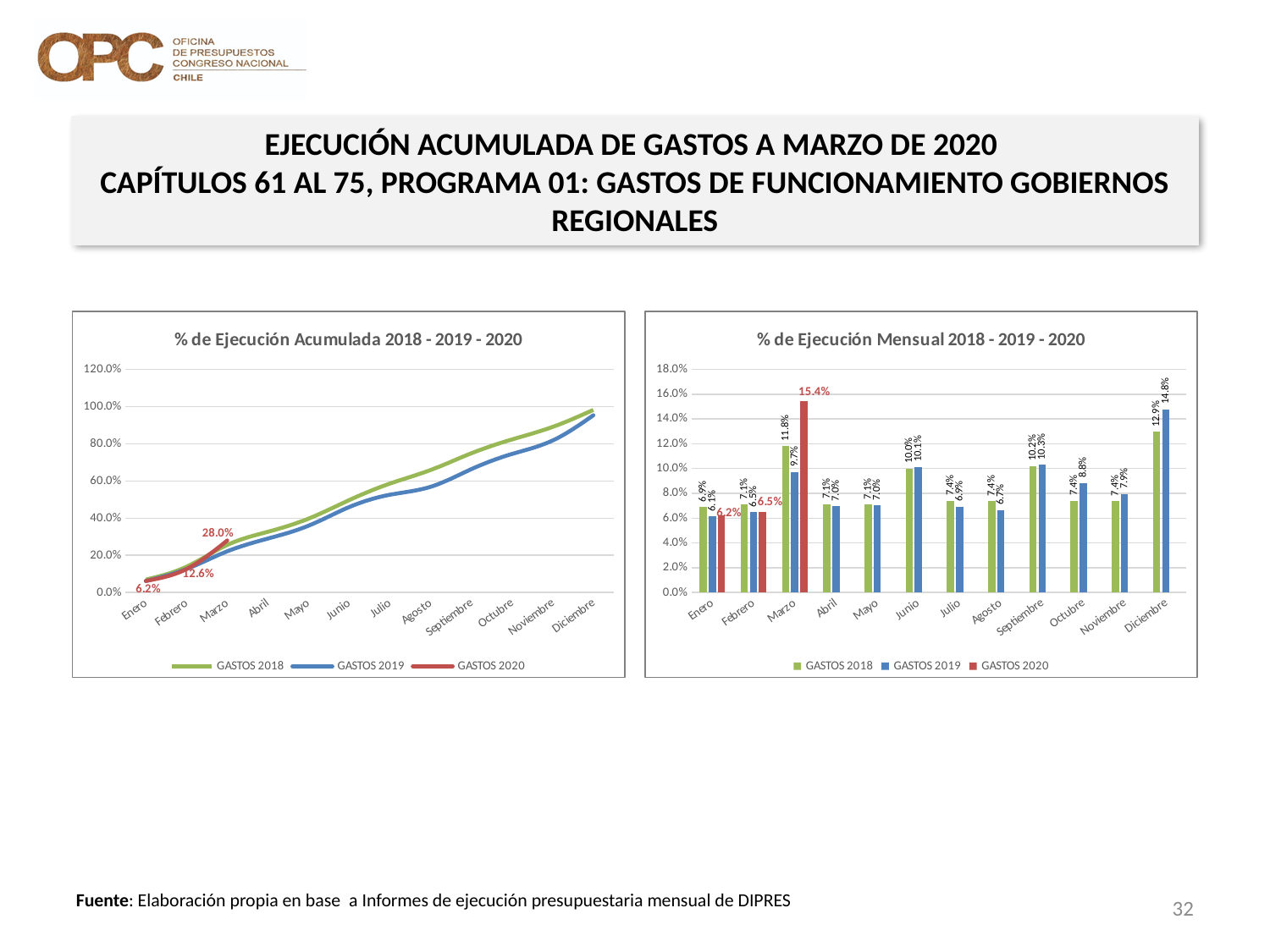
What kind of chart is the left chart titled '% de Ejecución Acumulada 2018 - 2019 - 2020'? Line chart What kind of chart is the right chart titled '% de Ejecución Mensual 2018 - 2019 - 2020'? Bar chart In the right chart '% de Ejecución Mensual', which month has the highest GASTOS 2018 value? Diciembre In the left chart '% de Ejecución Acumulada', does the GASTOS 2018 line rise or fall from Enero to Diciembre? Rises How many series does the legend of the right chart '% de Ejecución Mensual' list? 3 In the right chart '% de Ejecución Mensual', what is the GASTOS 2019 value for Octubre? 8.8% In the right chart '% de Ejecución Mensual', which is larger for Diciembre: GASTOS 2018 or GASTOS 2019? GASTOS 2019 In the right chart '% de Ejecución Mensual', which month has the lowest GASTOS 2019 value? Enero In the right chart '% de Ejecución Mensual', what is the difference between the GASTOS 2020 and GASTOS 2019 values for Marzo? 5.7 percentage points In the left chart '% de Ejecución Acumulada', what is the GASTOS 2020 value for Marzo? 28.0% In the right chart '% de Ejecución Mensual', what is the GASTOS 2020 value for Marzo? 15.4% In the left chart '% de Ejecución Acumulada', what is the GASTOS 2020 value for Febrero? 12.6%